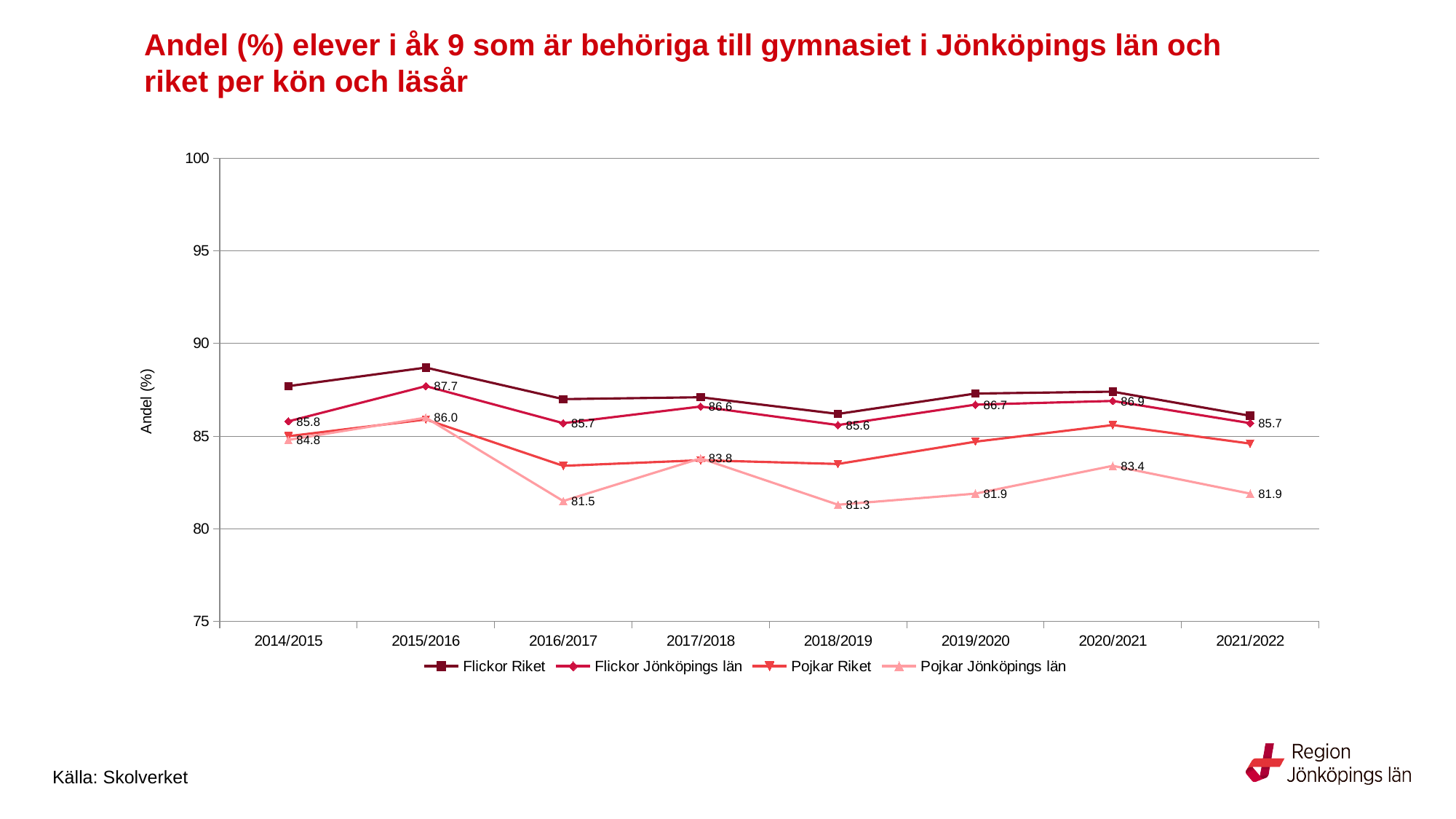
What is the value for Pojkar Jönköpings län in 2018/2019? 81.3 What is the difference between Flickor Jönköpings län and Pojkar Jönköpings län in 2016/2017? 4.2 What type of chart is shown on the slide? line chart In which school year is the value for Pojkar Jönköpings län lowest? 2018/2019 What is the value for Flickor Jönköpings län in 2015/2016? 87.7 How many school years (läsår) are shown on the x axis? 8 How many series does the legend list? 4 Is the value for Pojkar Riket in 2016/2017 greater or less than 85? less In which school year is the value for Pojkar Jönköpings län highest? 2015/2016 What is the label of the y axis? Andel (%) Which is larger in 2020/2021: Flickor Jönköpings län or Pojkar Jönköpings län? Flickor Jönköpings län What is the value for Pojkar Jönköpings län in 2021/2022? 81.9